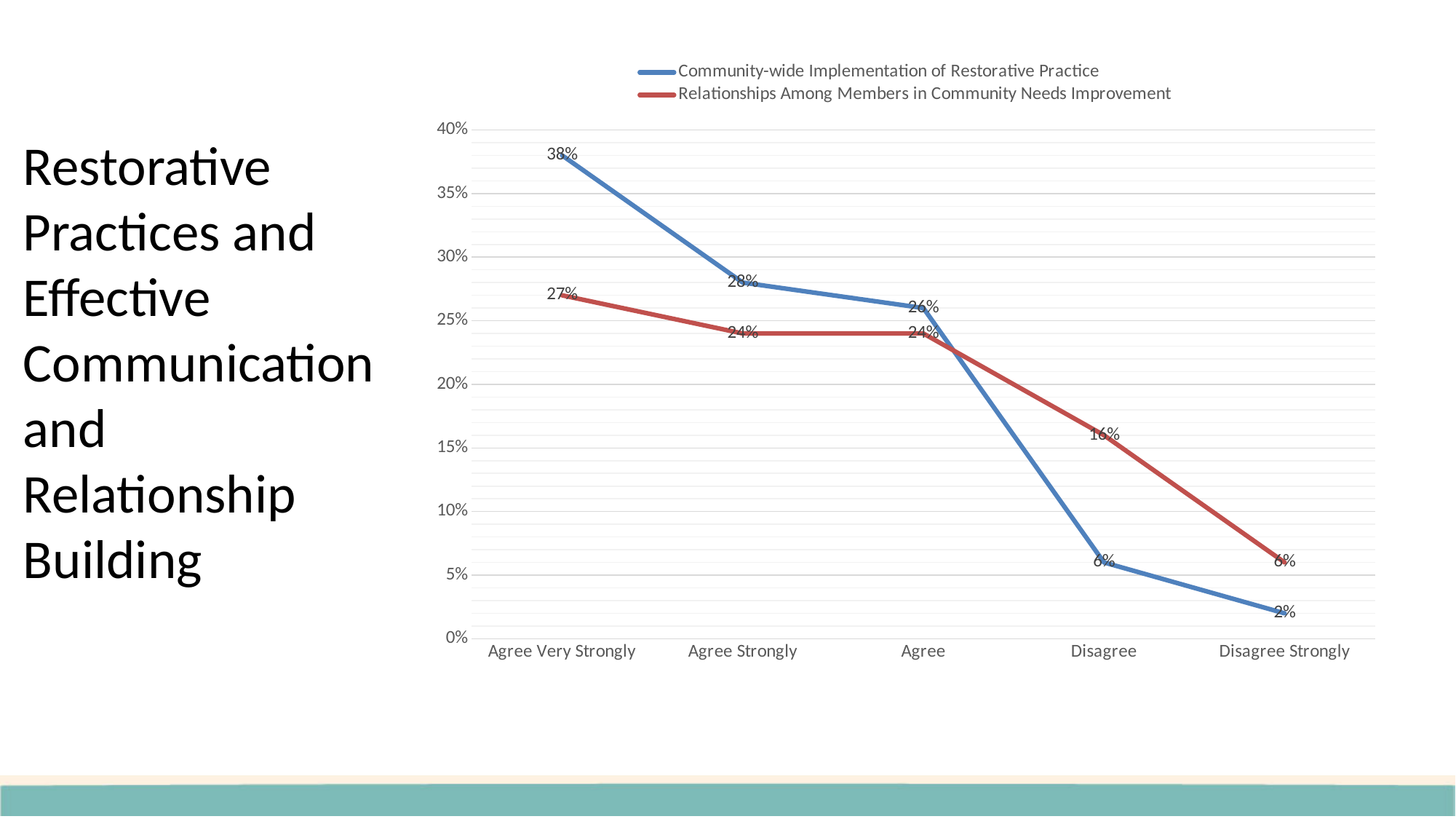
Which category has the highest value in the Relationships Among Members in Community Needs Improvement series? Agree Very Strongly What is the difference between the two series at Disagree? 10% What is the value for Disagree Strongly in the Community-wide Implementation of Restorative Practice series? 2% Do the values of the Community-wide Implementation of Restorative Practice series rise or fall from Agree Very Strongly to Disagree Strongly? Fall Which category has the lowest value in the Community-wide Implementation of Restorative Practice series? Disagree Strongly What type of chart is shown on the slide? Line chart What is the value for Agree Very Strongly in the Community-wide Implementation of Restorative Practice series? 38% How many response categories are shown on the x axis? 5 What is the value for Disagree in the Relationships Among Members in Community Needs Improvement series? 16% At Agree Very Strongly, which series has the larger value? Community-wide Implementation of Restorative Practice How many series does the legend list? 2 What colour is the line for Relationships Among Members in Community Needs Improvement? Red